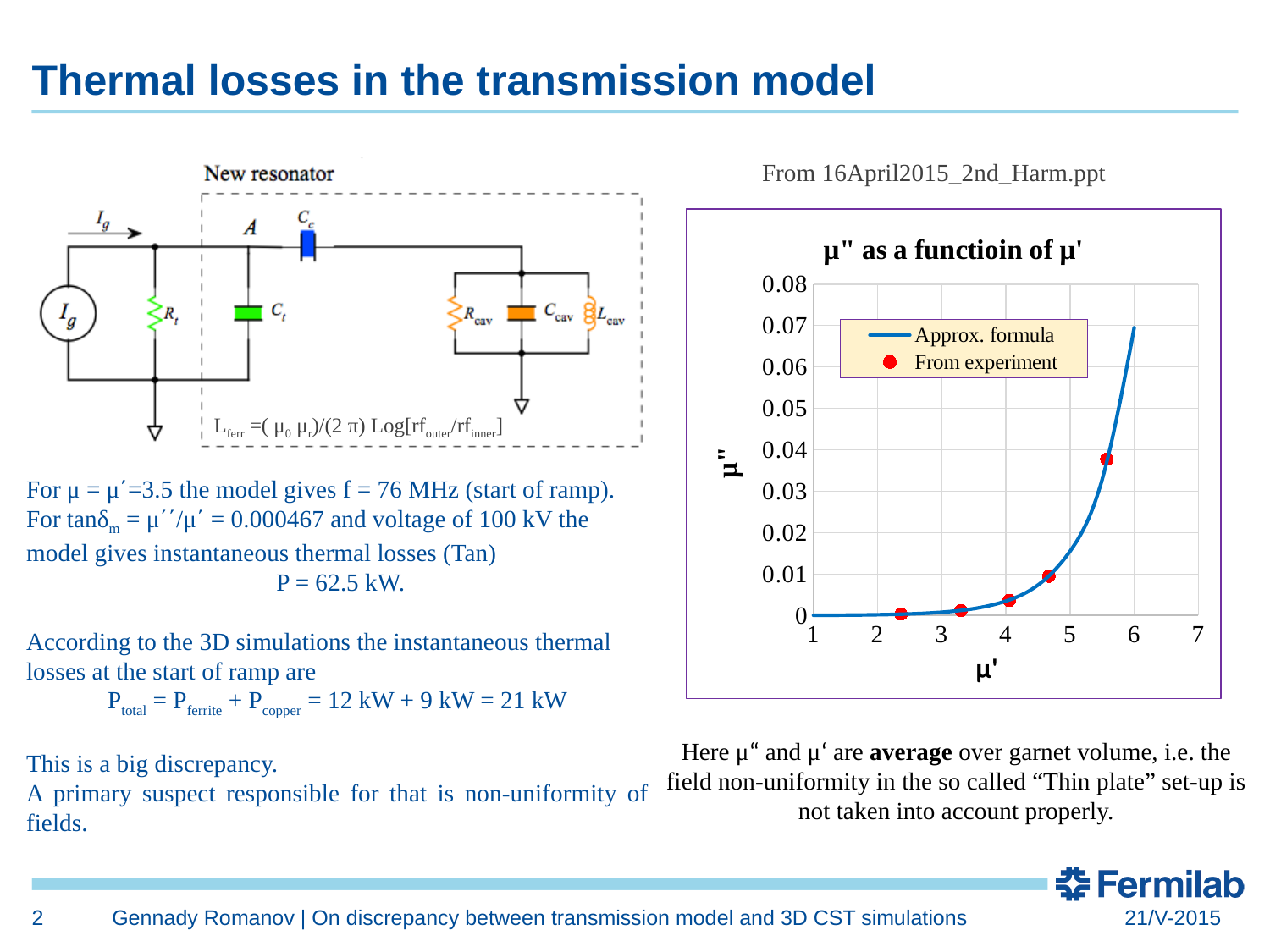
Which experimental point has the larger μ" value: the one near μ' = 5.6 or the one near μ' = 4.7? the one near μ' = 5.6 Does μ" rise or fall as μ' increases along the x axis? rise What is the title of the chart? μ" as a functioin of μ' Is the experimental value of μ" at the rightmost red point (near μ' = 5.6) greater or less than 0.03? greater Is the value of the Approx. formula curve at μ' = 5 greater or less than 0.03? less How many experimental data points (red dots) are plotted on the chart? 5 What is the highest tick value shown on the y axis of the chart? 0.08 What kind of chart is shown on the slide? line chart with scatter points Is the value of the Approx. formula curve at μ' = 4 greater or less than 0.01? less How many series does the chart legend list? 2 What are the two series named in the chart legend? Approx. formula; From experiment